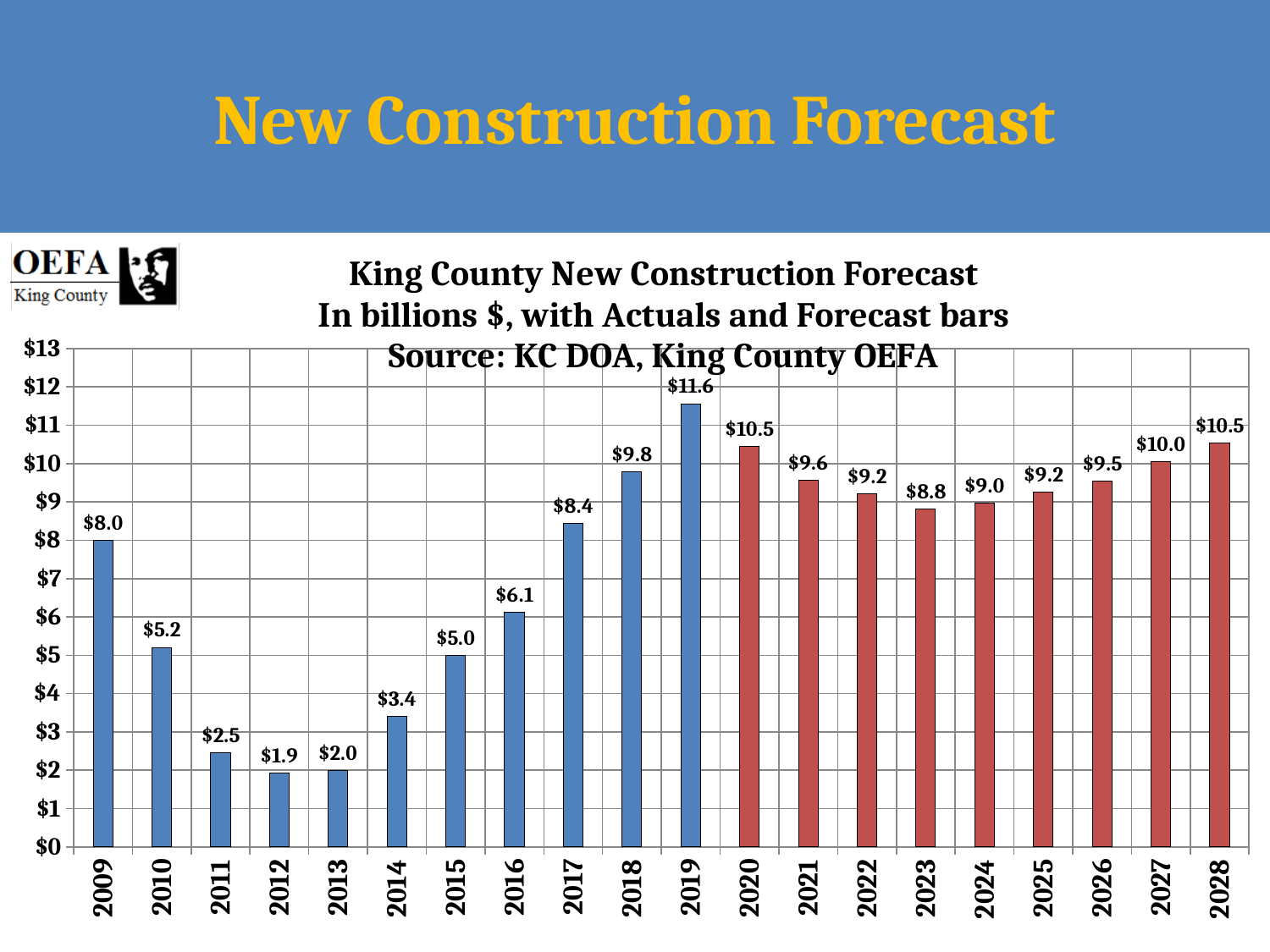
Is the value for 2014 greater or less than $4? less Which year has the lowest value? 2012 What is the difference between the values for 2028 and 2023? $1.7 What kind of chart is shown? bar chart Do the values rise or fall from 2012 to 2019? rise What is the value for 2019? $11.6 Which year has the highest value? 2019 How many years are shown on the x axis? 20 What is the value for 2024? $9.0 What is the value for 2012? $1.9 Which is larger, the value for 2009 or the value for 2017? 2017 What is the difference between the values for 2019 and 2012? $9.7